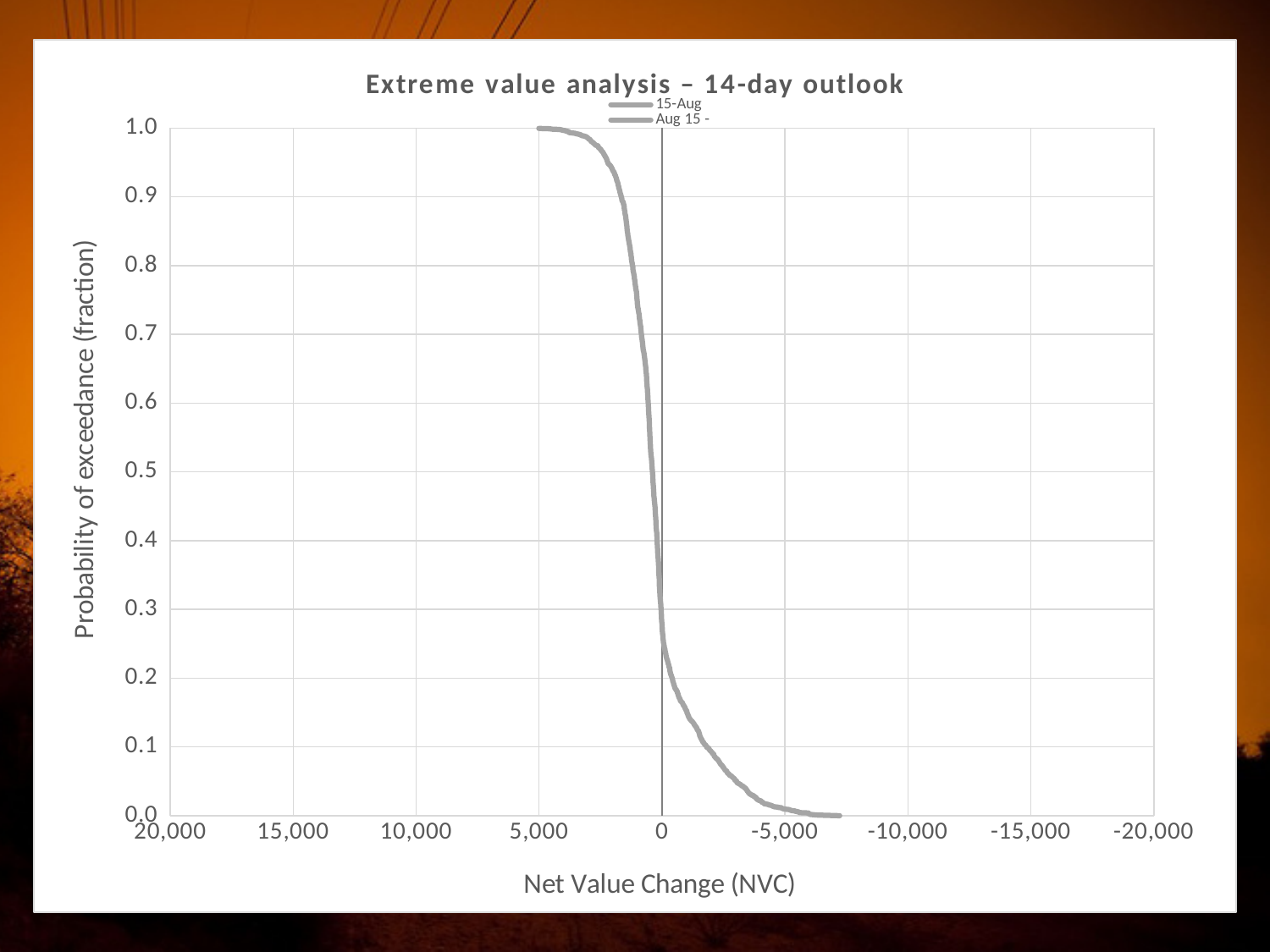
Is the probability of exceedance at a Net Value Change of 0 greater or less than 0.1? greater What kind of chart is shown on the slide? line chart Does the probability of exceedance rise or fall moving from left to right along the x axis? fall What is the title of the chart? Extreme value analysis – 14-day outlook Is the probability of exceedance at a Net Value Change of 0 greater or less than 0.5? less Is the probability of exceedance at a Net Value Change of 5,000 greater or less than 0.5? greater What is the label of the x axis? Net Value Change (NVC) How many series does the legend list? 2 Which has the higher probability of exceedance: a Net Value Change of 5,000 or a Net Value Change of -5,000? 5,000